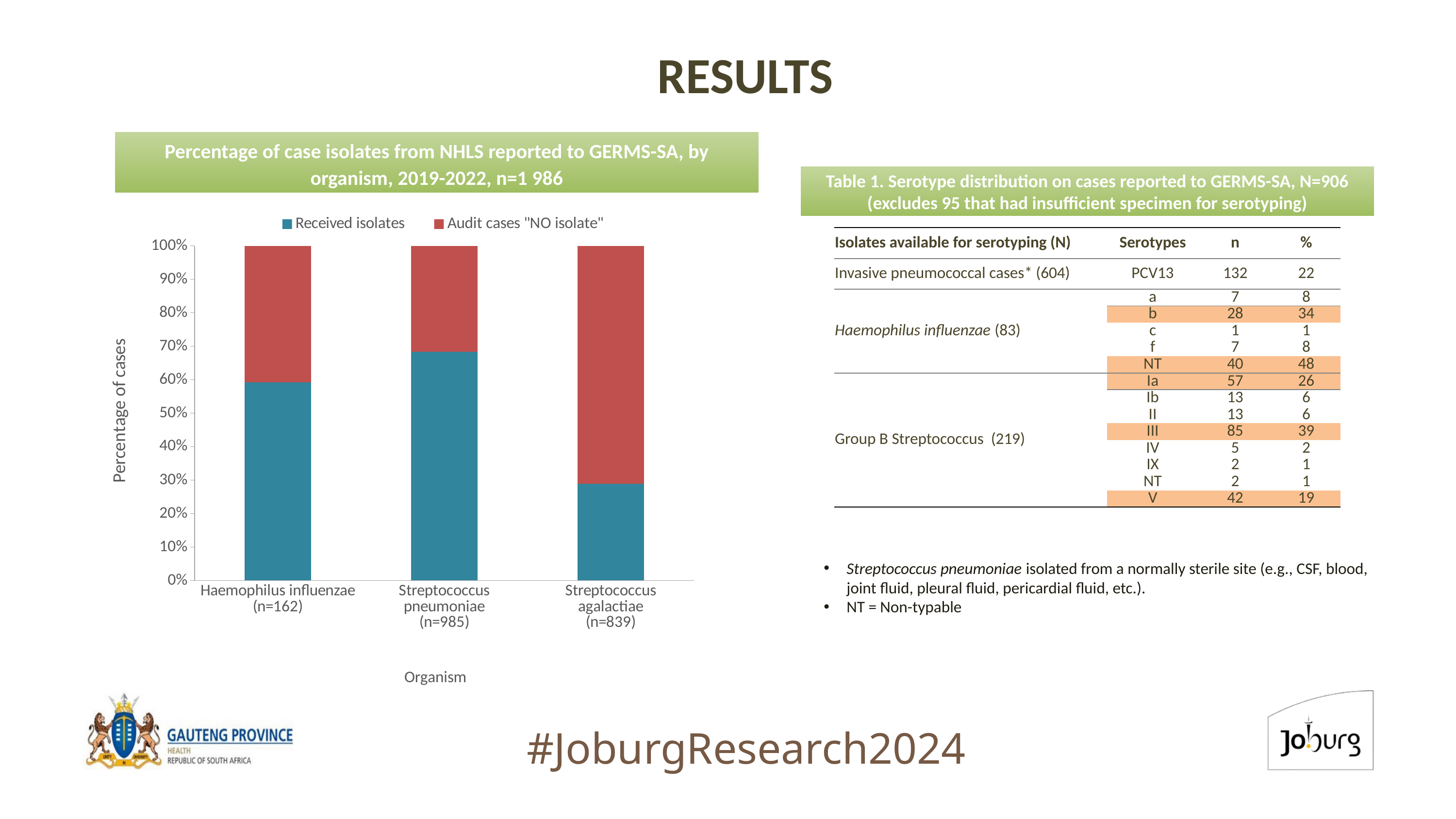
How many series does the chart legend list? 2 Is the percentage of received isolates for Streptococcus agalactiae greater or less than 30%? less Which has a larger share of received isolates: Haemophilus influenzae or Streptococcus agalactiae? Haemophilus influenzae Is the percentage of received isolates for Haemophilus influenzae greater or less than 50%? greater Which organism has the highest percentage of received isolates? Streptococcus pneumoniae What is the sample size (n) shown for Streptococcus pneumoniae on the x axis? n=985 Which organism has the largest share of audit cases "NO isolate"? Streptococcus agalactiae What is the total height of each stacked bar in the chart? 100% Is the percentage of received isolates for Streptococcus pneumoniae greater or less than 60%? greater Which organism has the lowest percentage of received isolates? Streptococcus agalactiae How many organisms (categories) are shown on the x axis of the chart? 3 What kind of chart is shown on the slide? stacked bar chart